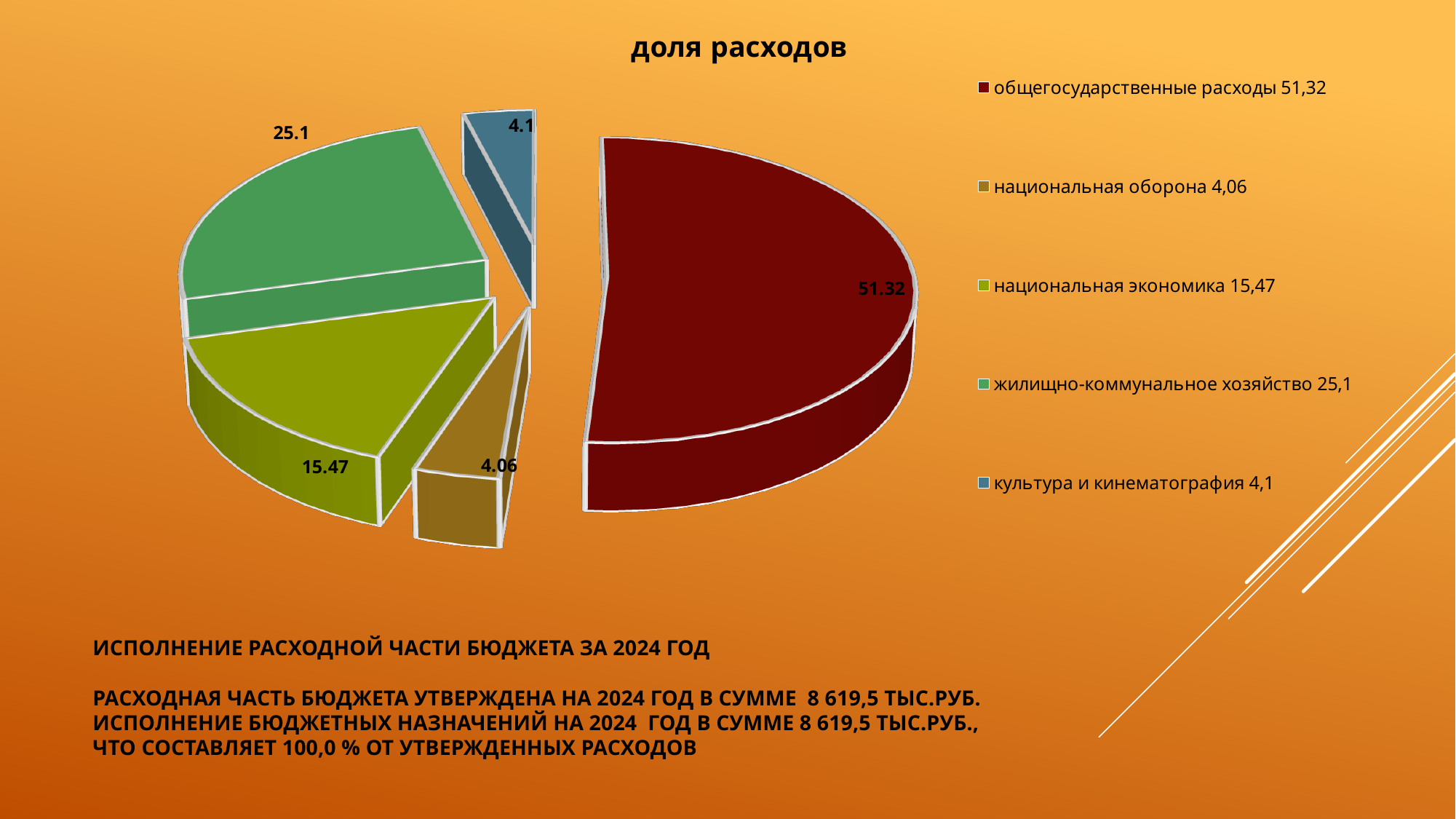
What is the difference between the values for общегосударственные расходы and жилищно-коммунальное хозяйство? 26.22 Which is larger: the value for национальная экономика or the value for жилищно-коммунальное хозяйство? жилищно-коммунальное хозяйство What kind of chart is shown on the slide? pie chart What is the value for общегосударственные расходы in the pie chart? 51.32 What is the value for жилищно-коммунальное хозяйство in the pie chart? 25.1 What is the value for национальная оборона in the pie chart? 4.06 Which category has the smallest slice in the pie chart? национальная оборона What is the title of the chart? доля расходов What is the value for национальная экономика in the pie chart? 15.47 Which category has the largest slice in the pie chart? общегосударственные расходы How many slices does the pie chart have? 5 What is the value for культура и кинематография in the pie chart? 4.1